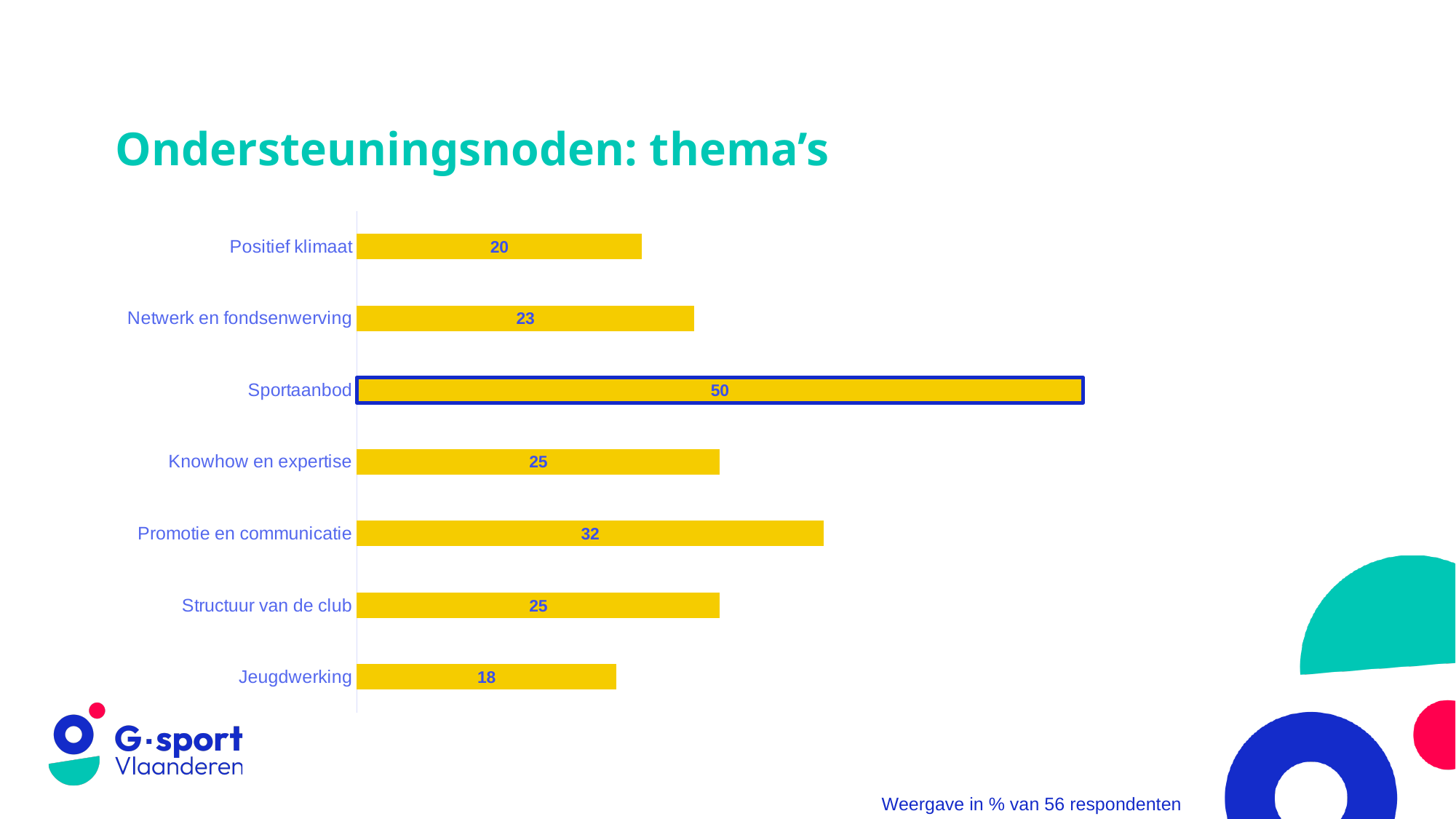
How many categories are shown in the chart? 7 Which category has the highest value? Sportaanbod What is the value for Promotie en communicatie? 32 What kind of chart is shown on the slide? Bar chart What is the difference between the values for Positief klimaat and Jeugdwerking? 2 Which is larger, the value for Knowhow en expertise or the value for Netwerk en fondsenwerving? Knowhow en expertise What is the value for Netwerk en fondsenwerving? 23 Which category has the lowest value? Jeugdwerking Which bar is highlighted with a blue outline? Sportaanbod What is the value for Sportaanbod? 50 What is the difference between the values for Sportaanbod and Promotie en communicatie? 18 What is the value for Jeugdwerking? 18